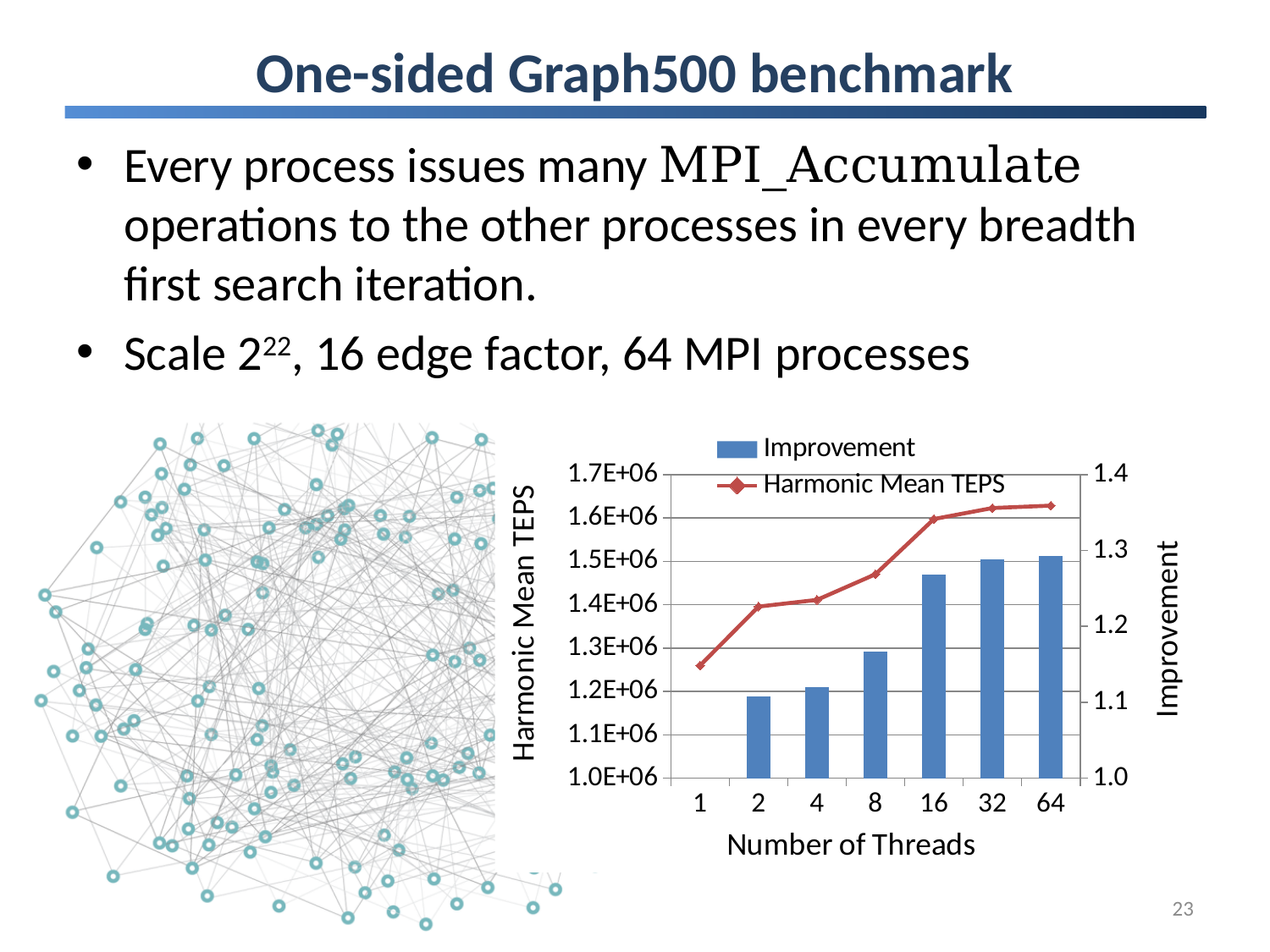
Is the Improvement value for 2 threads greater or less than 1.2? less Is the Improvement value for 16 threads greater or less than 1.2? greater Is the Harmonic Mean TEPS value for 1 thread greater or less than 1.3E+06? less What kind of chart is shown on the slide? A combination bar and line chart Which has the larger Harmonic Mean TEPS, 8 threads or 16 threads? 16 threads How many series does the chart legend list? 2 Which has the larger Improvement, 4 threads or 16 threads? 16 threads Does the Harmonic Mean TEPS line rise or fall as the number of threads increases? Rises At which number of threads is the Harmonic Mean TEPS lowest? 1 How many thread counts are plotted along the x axis? 7 What is the title of the x axis of the chart? Number of Threads